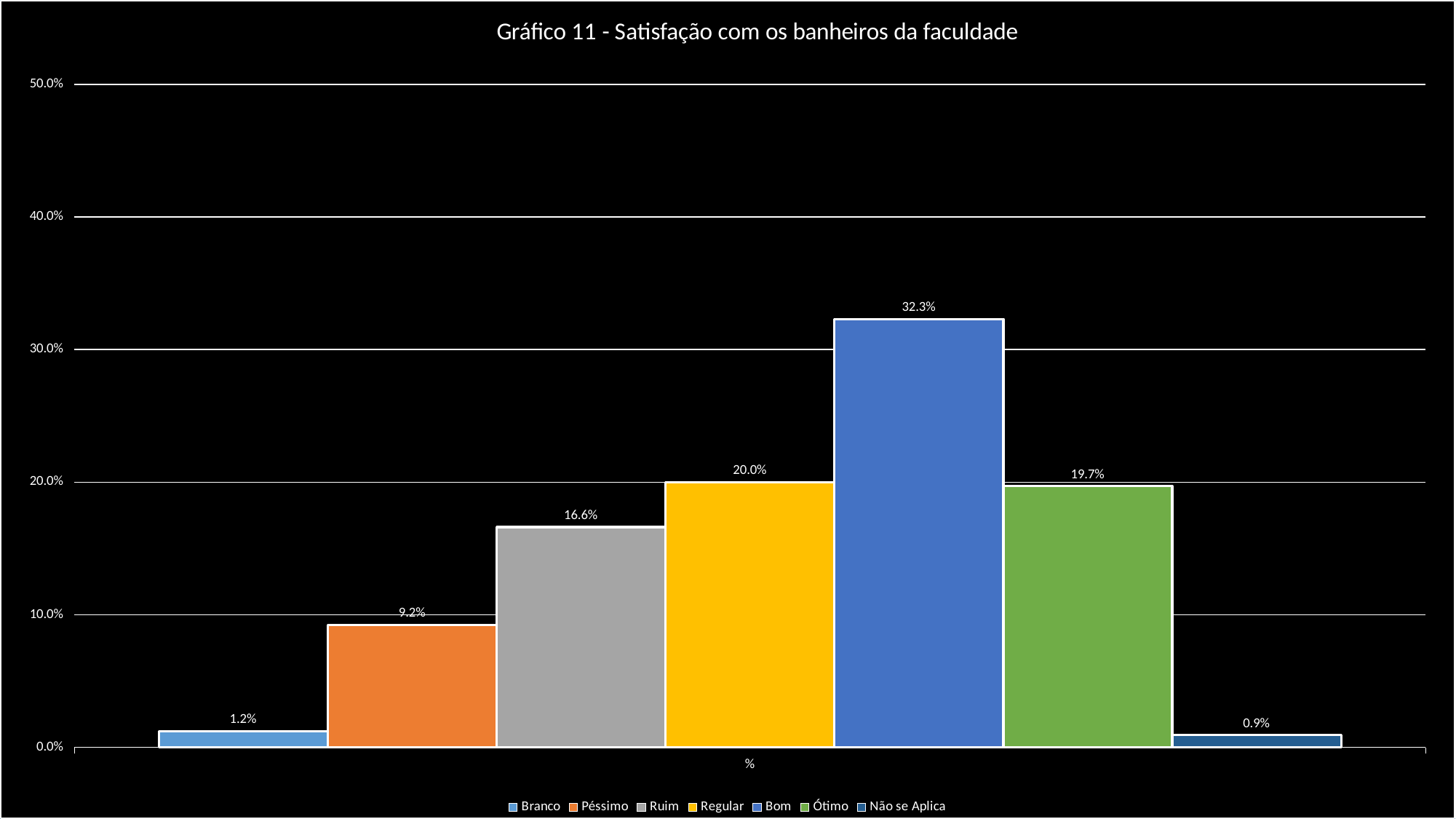
What is the value for Não se Aplica? 0.9% What is the difference between the values for Bom and Regular? 12.3% What is the value for Bom? 32.3% What is the value for Péssimo? 9.2% Which is larger, the value for Regular or the value for Ótimo? Regular What is the difference between the values for Ruim and Péssimo? 7.4% Which series has the lowest value? Não se Aplica Which series has the highest value? Bom What is the value for Ruim? 16.6% What is the title of the chart? Gráfico 11 - Satisfação com os banheiros da faculdade What kind of chart is shown? Bar chart How many series does the legend list? 7